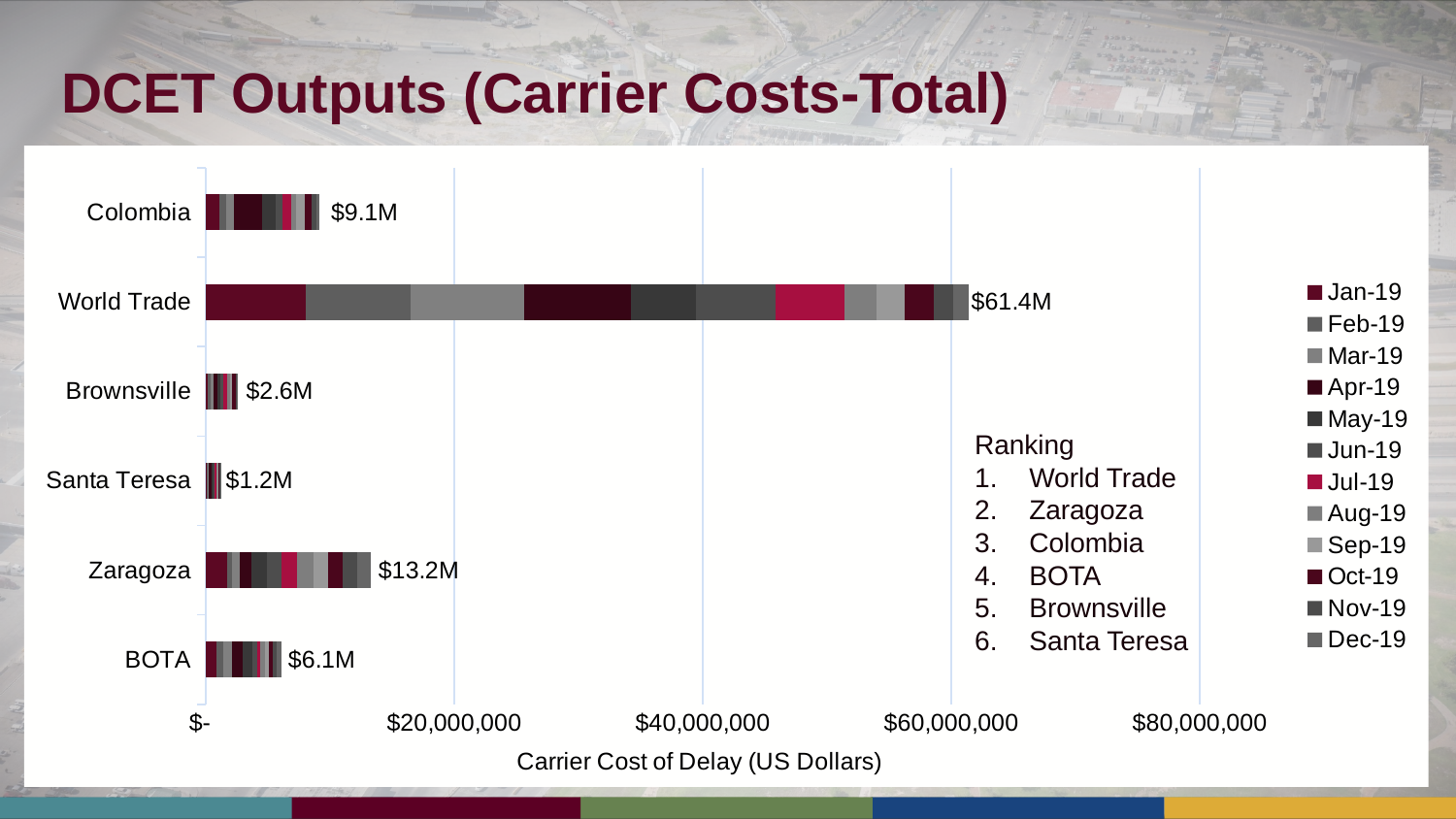
What is the total carrier cost of delay shown for Santa Teresa? $1.2M Which port of entry has the highest total carrier cost of delay? World Trade Which port of entry has the lowest total carrier cost of delay? Santa Teresa Is the total carrier cost of delay for Zaragoza greater or less than $20,000,000? less How many series does the legend list? 12 How many ports of entry are shown on the chart? 6 What is the total carrier cost of delay shown for World Trade? $61.4M What is the total carrier cost of delay shown for Zaragoza? $13.2M Which has a larger total carrier cost of delay, Colombia or BOTA? Colombia What is the difference between the total carrier cost of delay for World Trade and Zaragoza? $48.2M What is the label of the x axis? Carrier Cost of Delay (US Dollars) What kind of chart is shown on the slide? Stacked bar chart